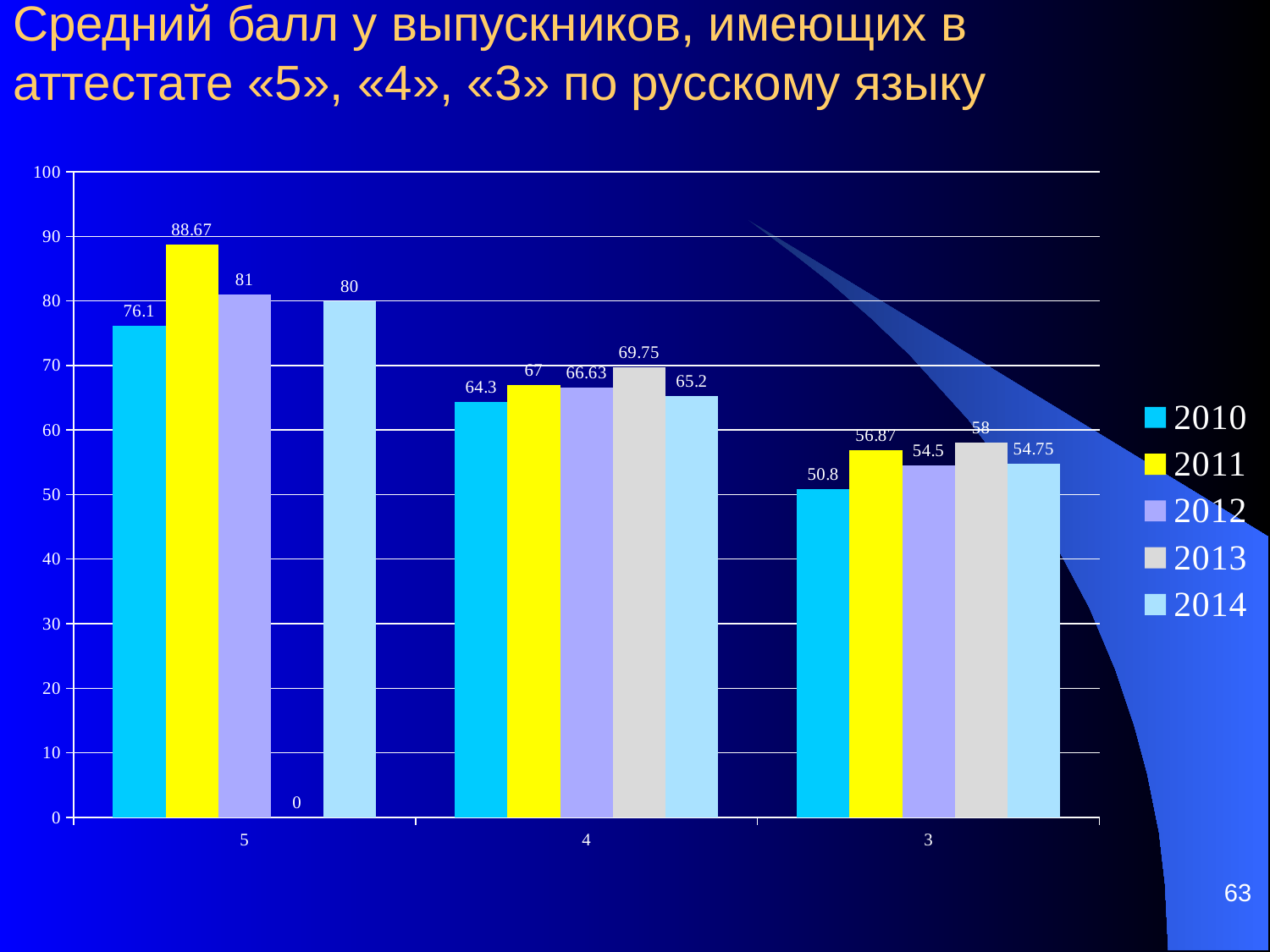
Which year has the lowest value in category 4? 2010 What is the difference between the 2011 and 2010 values in category 5? 12.57 What is the value for 2011 in category 5? 88.67 Which colour represents 2011 in the legend? yellow What is the value for 2010 in category 3? 50.8 How many categories are shown on the x axis? 3 What is the value for 2014 in category 5? 80 What kind of chart is shown on the slide? bar chart Which is larger in category 4: the value for 2012 or the value for 2014? 2012 Which year has the highest value in category 3? 2013 How many series does the legend list? 5 What is the value for 2013 in category 4? 69.75